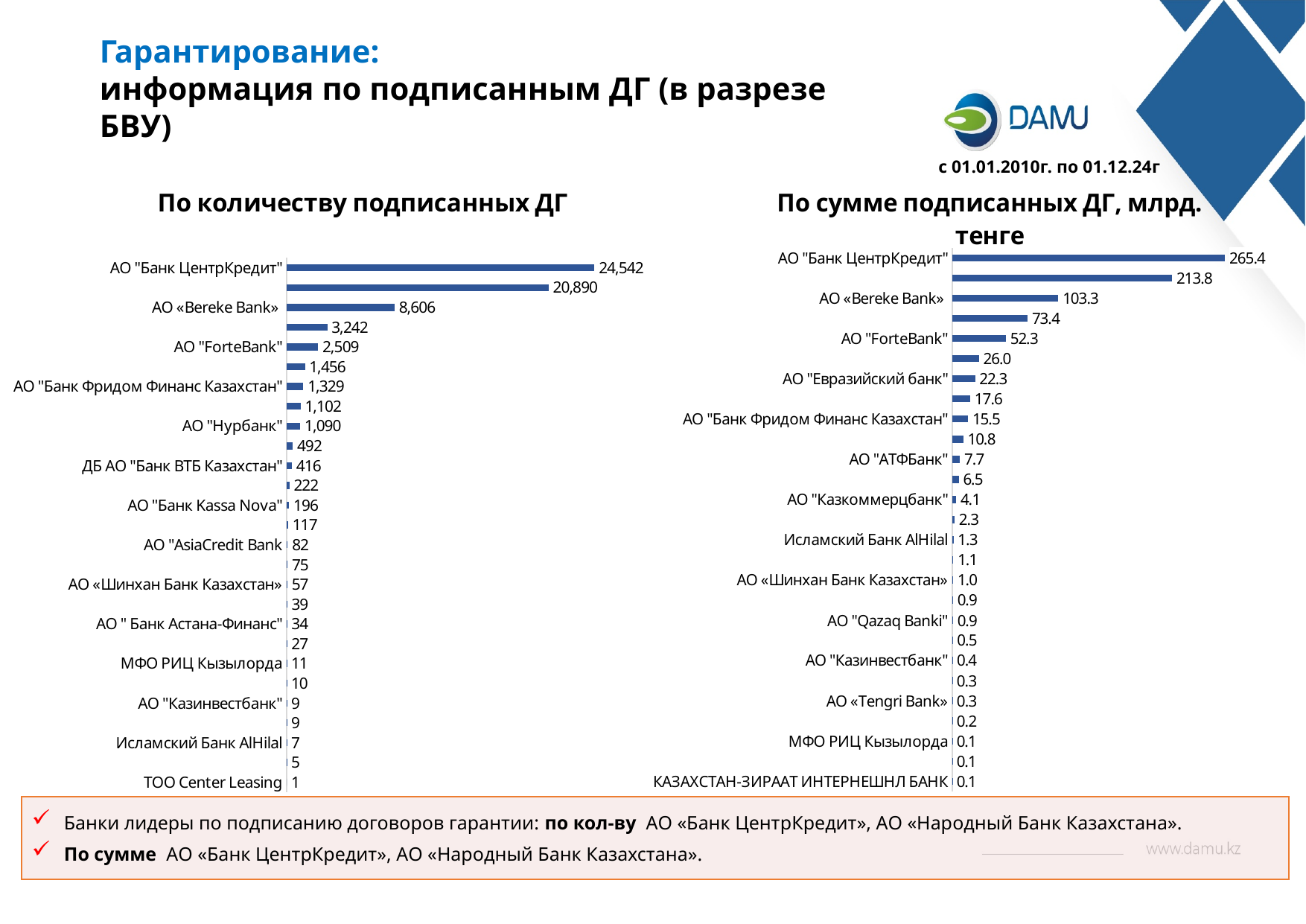
In the chart "По количеству подписанных ДГ", what is the value for АО "Банк ЦентрКредит"? 24,542 In the chart "По сумме подписанных ДГ, млрд. тенге", what is the value for АО "Банк ЦентрКредит"? 265.4 In the chart "По сумме подписанных ДГ, млрд. тенге", what is the value for АО "Евразийский банк"? 22.3 In the chart "По количеству подписанных ДГ", what is the value for АО «Bereke Bank»? 8,606 In the chart "По сумме подписанных ДГ, млрд. тенге", which bank has the highest value? АО "Банк ЦентрКредит" In the chart "По сумме подписанных ДГ, млрд. тенге", which is larger: АО «Bereke Bank» or АО "ForteBank"? АО «Bereke Bank» What type of chart is used on the left side of the slide ("По количеству подписанных ДГ")? Bar chart In the chart "По количеству подписанных ДГ", what is the value for АО "Нурбанк"? 1,090 In the chart "По количеству подписанных ДГ", which labeled bank has the lowest value? ТОО Center Leasing In the chart "По сумме подписанных ДГ, млрд. тенге", what is the value for АО "АТФБанк"? 7.7 In the chart "По сумме подписанных ДГ, млрд. тенге", what is the difference between АО «Bereke Bank» and АО "ForteBank"? 51.0 In the chart "По количеству подписанных ДГ", what is the difference between АО "ForteBank" and АО "Банк Фридом Финанс Казахстан"? 1,180